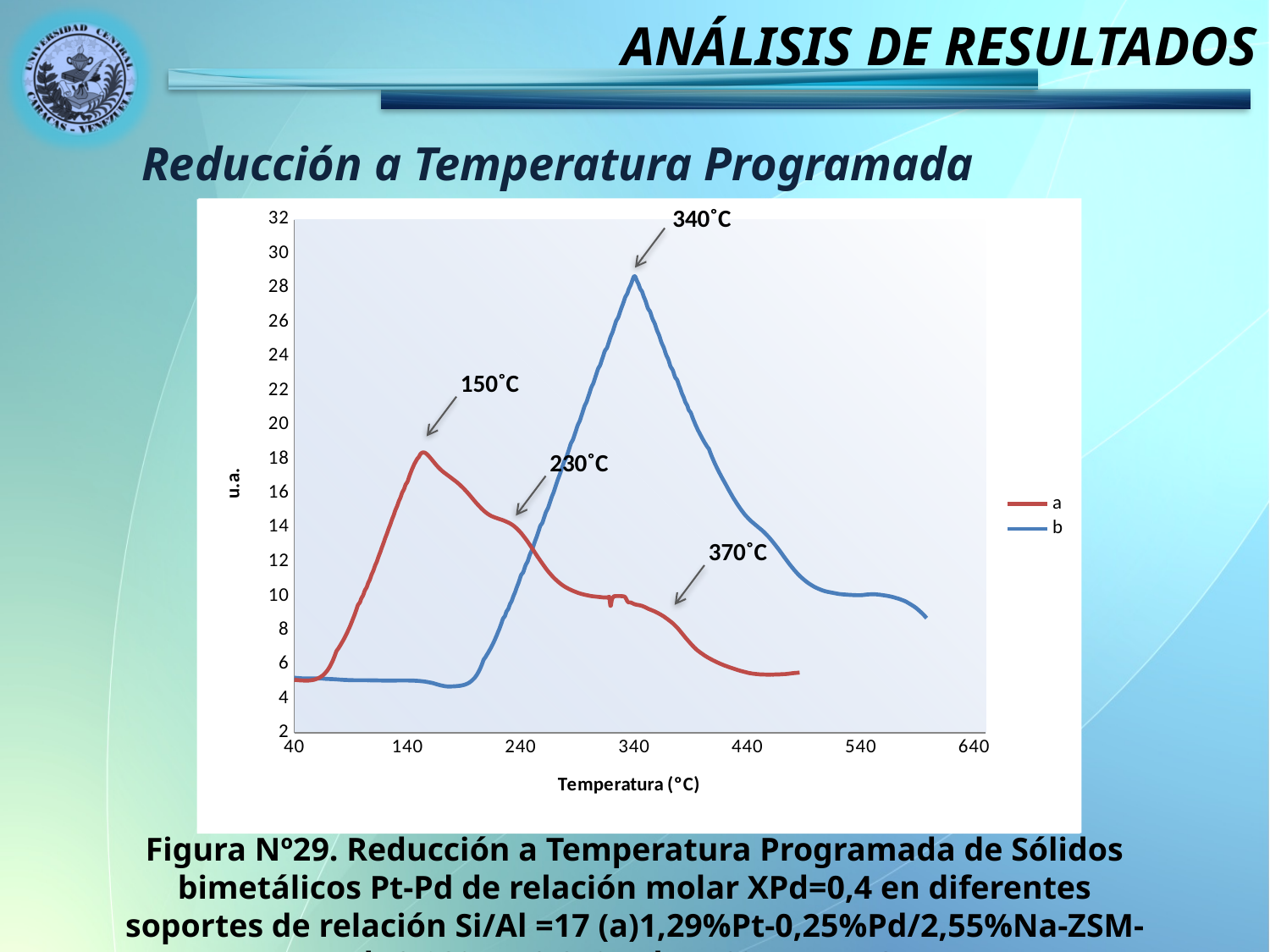
How many series does the legend list? 2 Which series, a or b, reaches the higher peak value? b What kind of chart is shown on the slide? line chart At what temperature is the peak of series b annotated? 340˚C Is the peak value of series a greater or less than 16? greater What are the names of the series in the legend? a and b What is the highest temperature tick shown on the x axis? 640 Is the peak value of series b greater or less than 26? greater Is the peak value of series a greater or less than 20? less What is the label of the x axis? Temperatura (°C) Which series, a or b, starts rising first along the temperature axis? a At what temperature is the highest peak of series a annotated? 150˚C